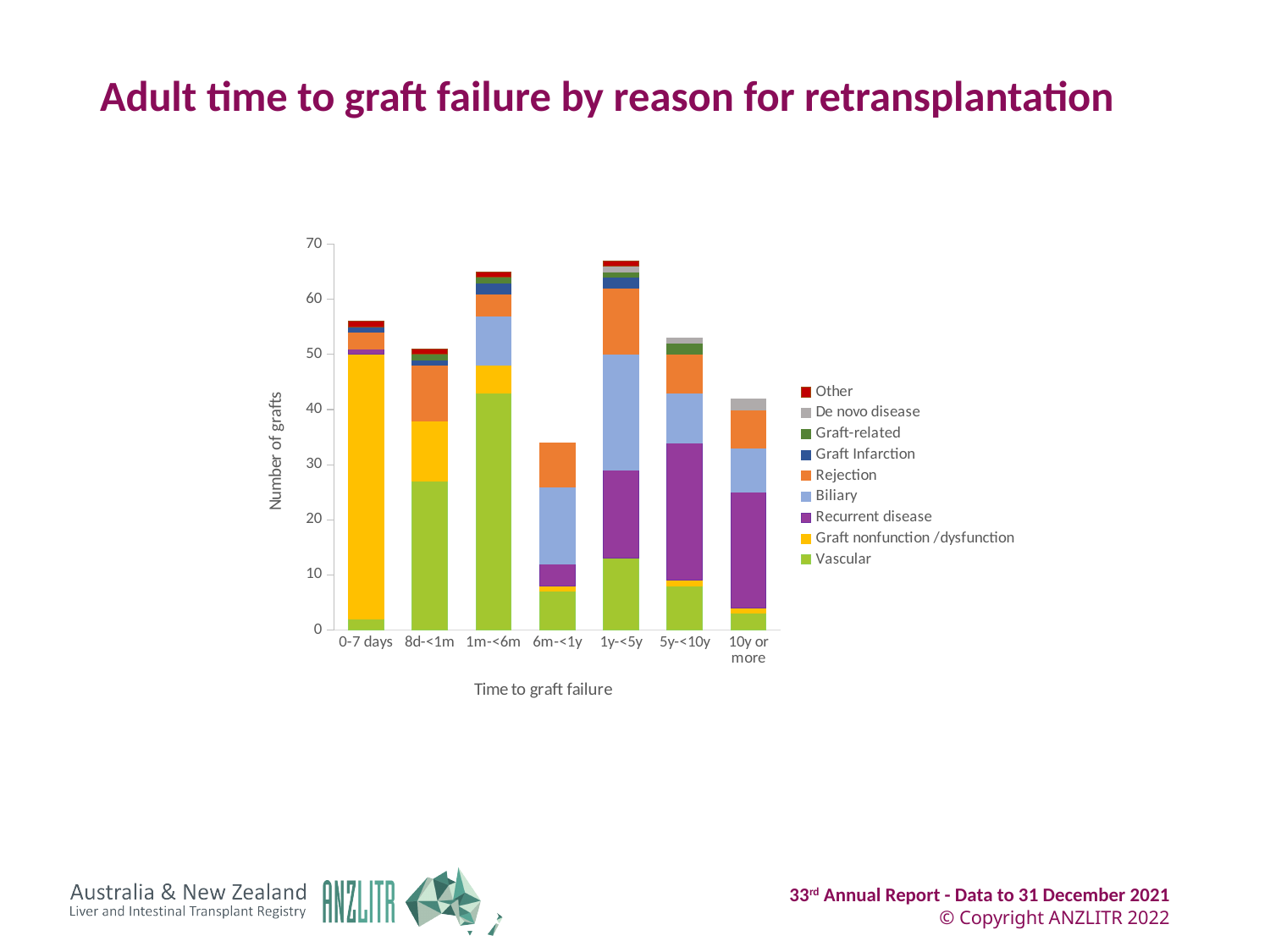
Which time-to-graft-failure category has the lowest total number of grafts? 6m-<1y Which has a larger total number of grafts, 5y-<10y or 10y or more? 5y-<10y Is the total number of grafts for 6m-<1y greater or less than 40? less How many series does the legend list? 9 Which has a larger total number of grafts, 0-7 days or 8d-<1m? 0-7 days Is the total number of grafts for 0-7 days greater or less than 50? greater What is the title of the chart? Adult time to graft failure by reason for retransplantation Is the total number of grafts for 10y or more greater or less than 50? less How many time-to-graft-failure categories are shown on the x axis? 7 What is the label on the y axis? Number of grafts What kind of chart is shown on the slide? Stacked bar chart